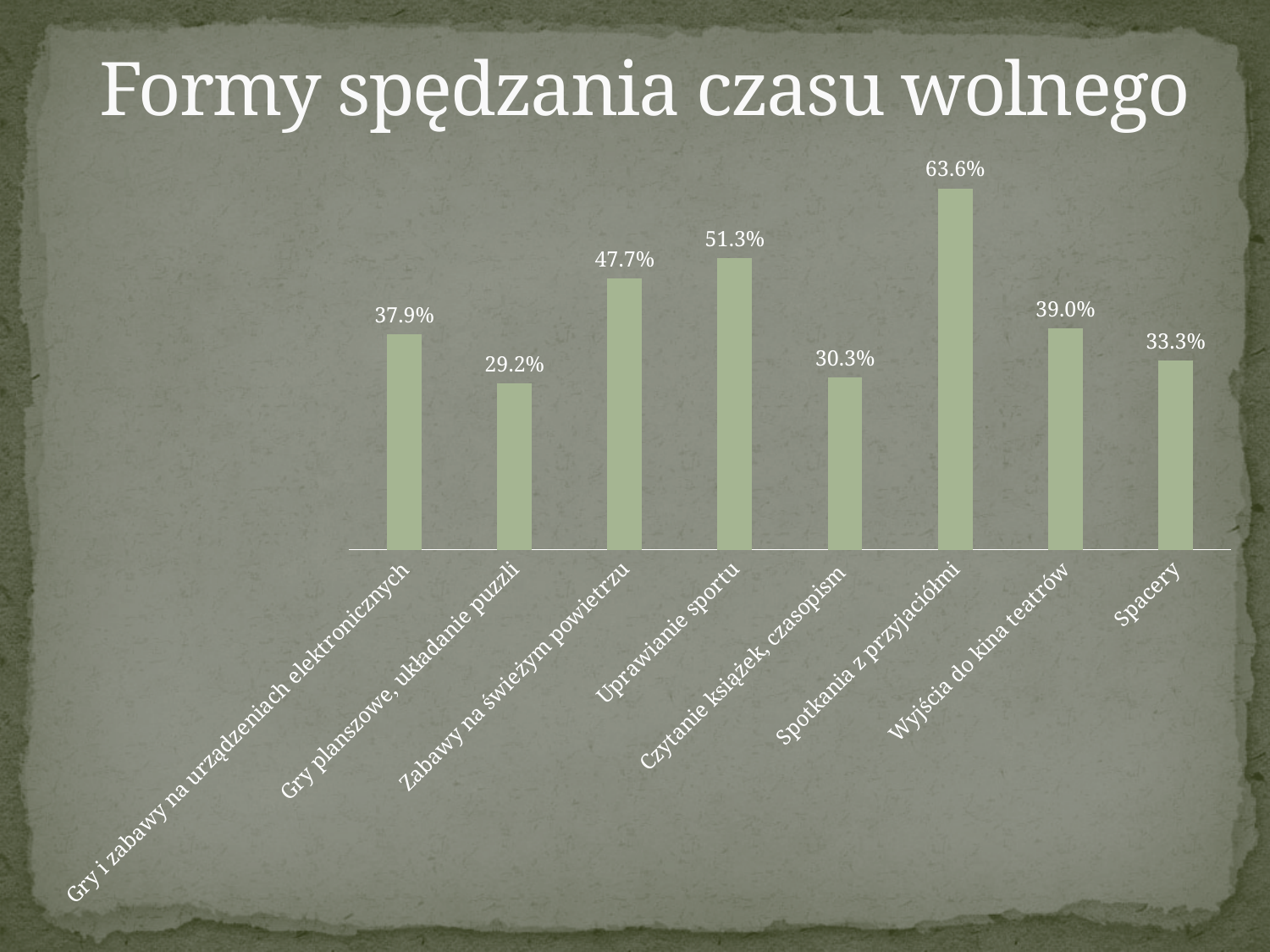
What kind of chart is shown on the slide? Bar chart What is the title of the slide? Formy spędzania czasu wolnego What is the difference between the values for Spotkania z przyjaciółmi and Uprawianie sportu? 12.3% Which is larger, the value for Wyjścia do kina teatrów or the value for Gry i zabawy na urządzeniach elektronicznych? Wyjścia do kina teatrów Which category has the lowest value? Gry planszowe, układanie puzzli What is the difference between the values for Zabawy na świeżym powietrzu and Czytanie książek, czasopism? 17.4% What is the value for Gry planszowe, układanie puzzli? 29.2% What is the value for Spotkania z przyjaciółmi? 63.6% What is the value for Spacery? 33.3% Which category has the highest value? Spotkania z przyjaciółmi How many categories are shown in the chart? 8 What is the value for Uprawianie sportu? 51.3%